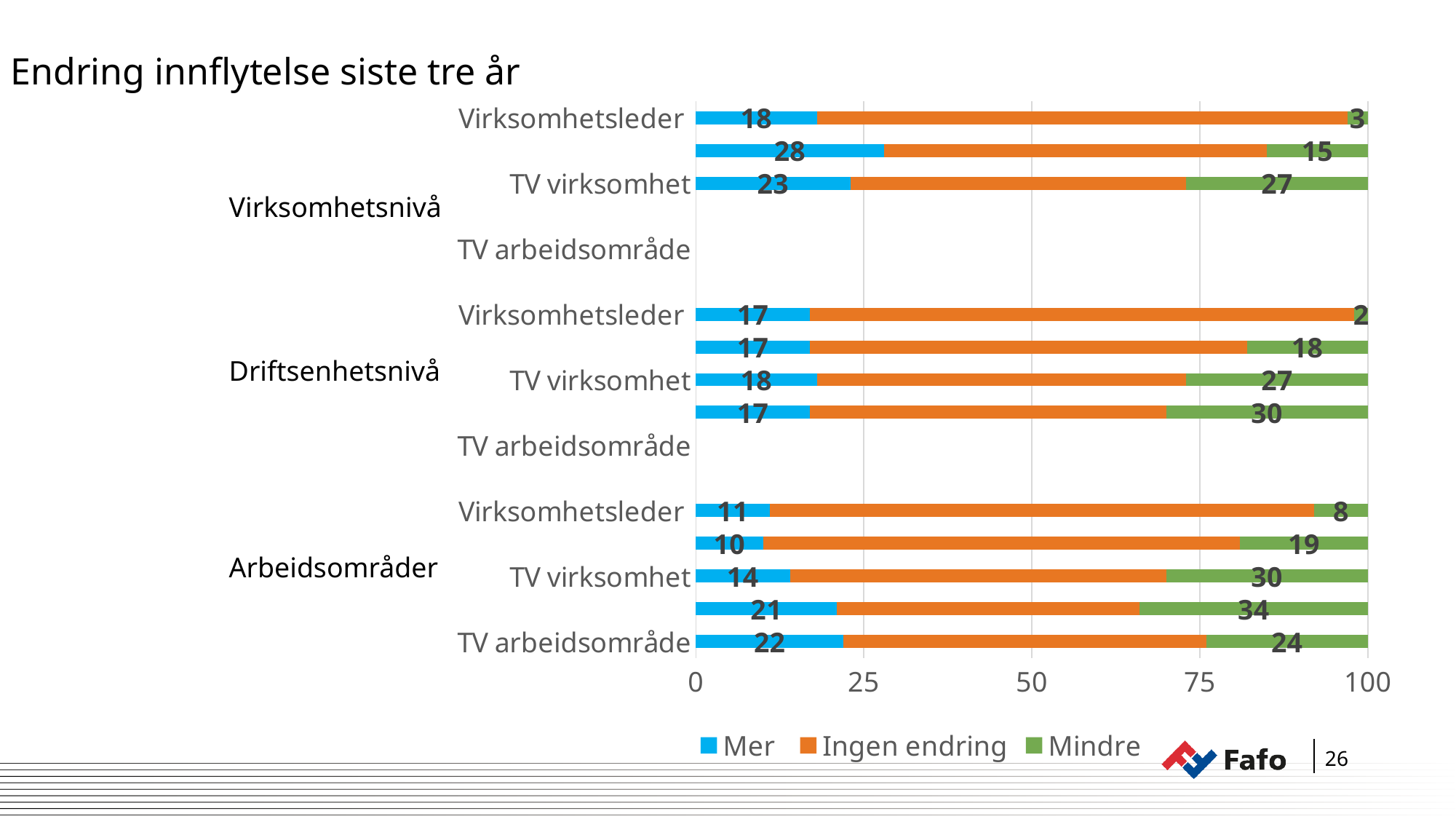
What kind of chart is shown on the slide? Stacked bar chart Under Virksomhetsnivå, which is larger for TV virksomhet: the Mer value or the Mindre value? Mindre What is the Mer value for Virksomhetsleder under Virksomhetsnivå? 18 What is the Mer value for TV arbeidsområde under Arbeidsområder? 22 What is the Mindre value for TV virksomhet under Arbeidsområder? 30 Among the three groups, which group's Virksomhetsleder bar has the highest Mer value? Virksomhetsnivå What are the three legend entries of the chart? Mer, Ingen endring, Mindre Is the Ingen endring value for Virksomhetsleder under Driftsenhetsnivå greater or less than 75? greater What is the Mindre value for Virksomhetsleder under Driftsenhetsnivå? 2 What is the Mindre value for TV virksomhet under Virksomhetsnivå? 27 How many series does the legend list? 3 Under Arbeidsområder, what is the difference between the Mindre and Mer values for TV arbeidsområde? 2